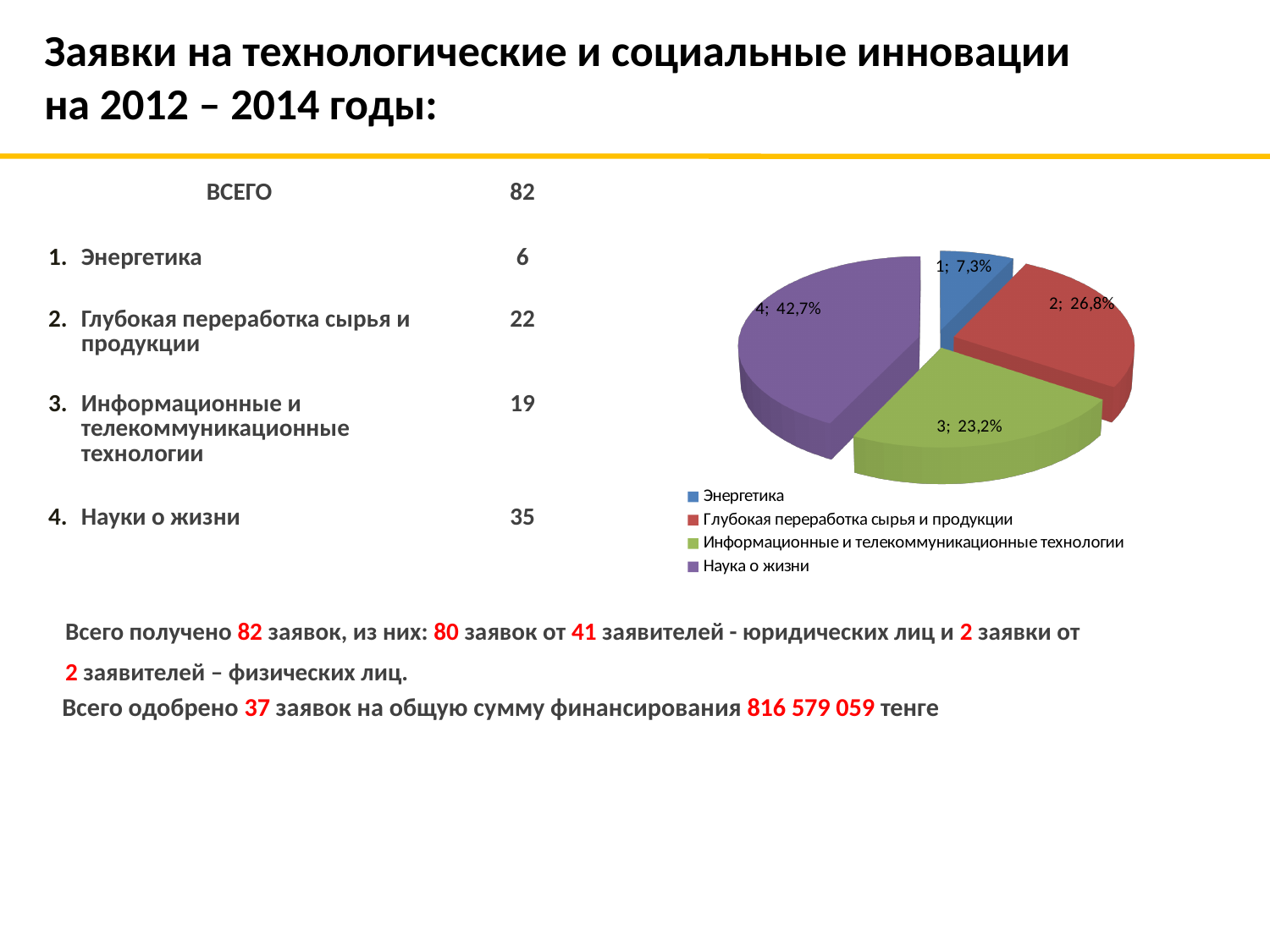
What percentage share does the pie chart show for Информационные и телекоммуникационные технологии? 23,2% What kind of chart is shown on the slide? pie chart How many slices does the pie chart have? 4 How many entries does the pie chart's legend list? 4 Which category has the largest slice in the pie chart? Наука о жизни Which category has the smallest slice in the pie chart? Энергетика What is the difference in percentage points between the Наука о жизни slice and the Энергетика slice? 35,4 What percentage share does the pie chart show for Энергетика? 7,3% What percentage share does the pie chart show for Наука о жизни? 42,7% What percentage share does the pie chart show for Глубокая переработка сырья и продукции? 26,8% What colour is the Наука о жизни slice in the pie chart? purple Which slice is larger in the pie chart: Глубокая переработка сырья и продукции or Информационные и телекоммуникационные технологии? Глубокая переработка сырья и продукции